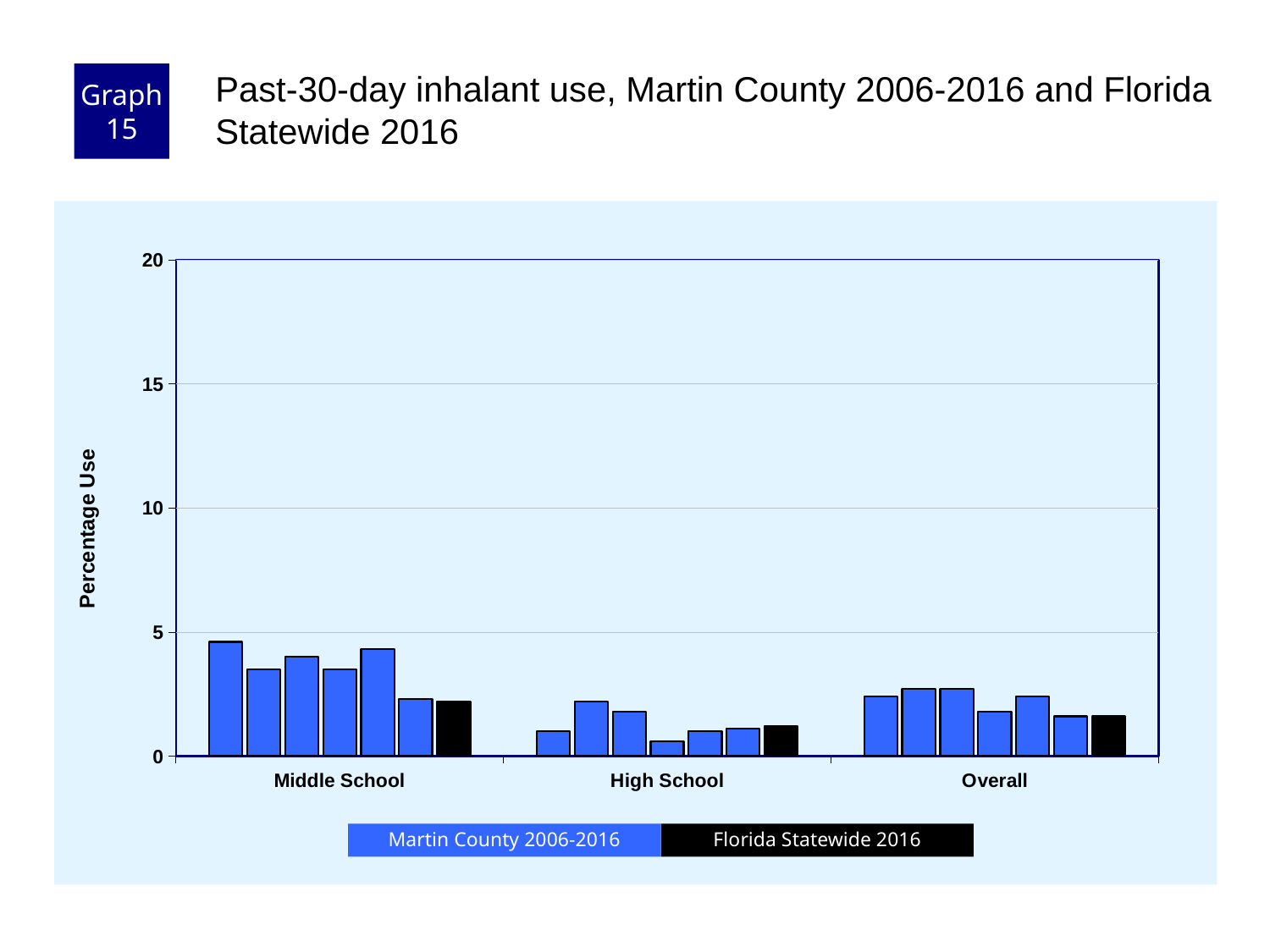
Which is larger: the Florida Statewide 2016 value for Middle School or for Overall? Middle School Which school-level group has the shortest bar in the chart? High School Is the highest Martin County bar in the Middle School group greater or less than 5? less How many school-level categories are shown on the x axis? 3 What kind of chart is shown on the slide? bar chart Which colour represents Florida Statewide 2016 in the legend? black Which is larger: the Florida Statewide 2016 value for Middle School or for High School? Middle School Is the Florida Statewide 2016 value for High School greater or less than 5? less How many series does the legend list? 2 Which school-level group has the tallest bar in the chart? Middle School Is the value for Florida Statewide 2016 in the Middle School group greater or less than 5? less What is the label on the y axis? Percentage Use